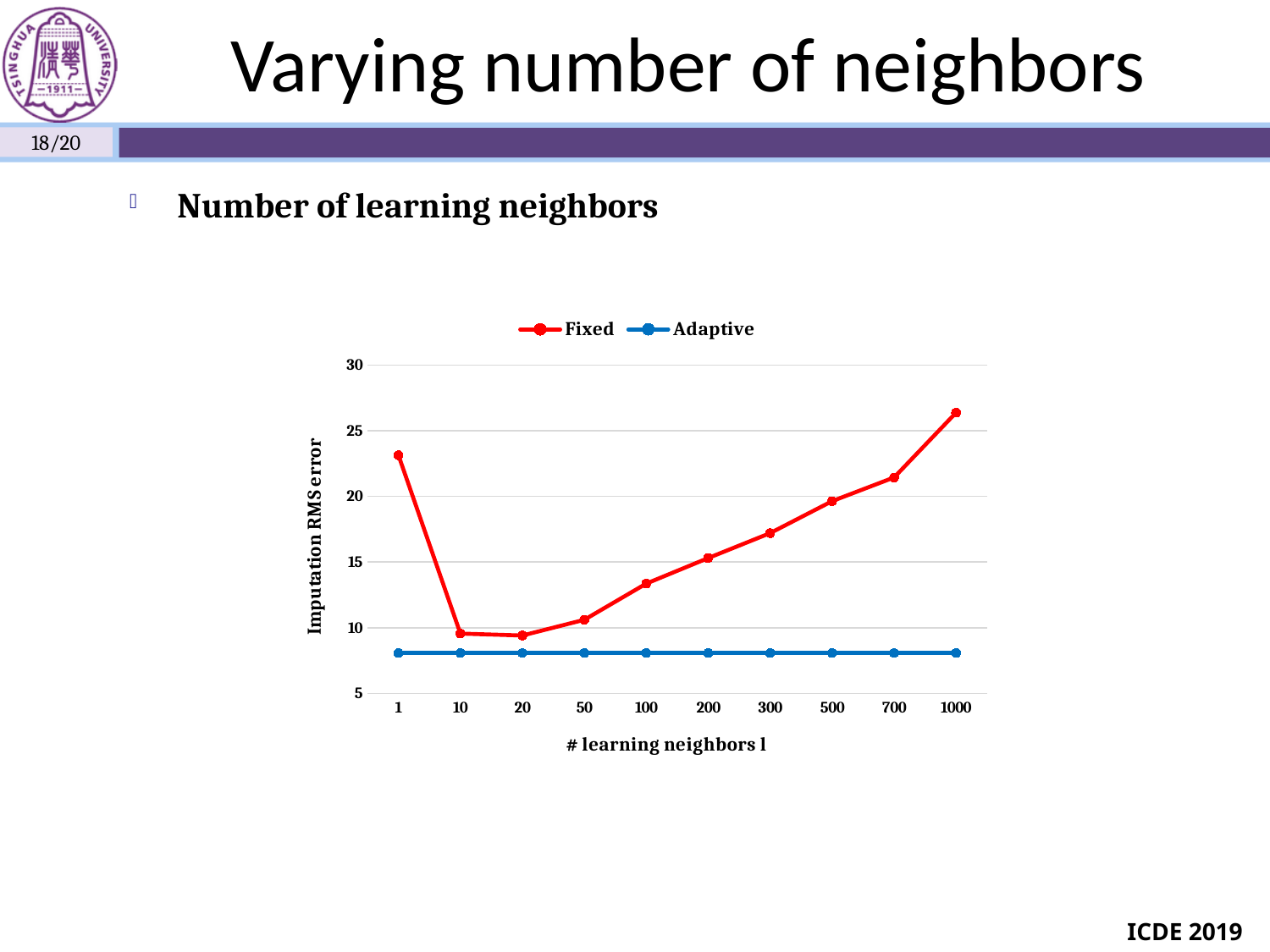
How many values of # learning neighbors l are plotted along the x axis? 10 What is the label of the y axis? Imputation RMS error Is the Fixed value at l = 1 greater or less than 20? greater At which number of learning neighbors does the Fixed series reach its highest imputation RMS error? 1000 How many series does the legend list? 2 What kind of chart is shown on the slide? line chart Is the Fixed value at l = 1000 greater or less than 25? greater At l = 500, which series has the higher imputation RMS error, Fixed or Adaptive? Fixed Is the Fixed value at l = 300 greater or less than 15? greater Which series is drawn in blue? Adaptive Does the Fixed series rise or fall as l increases from 50 to 1000? rise